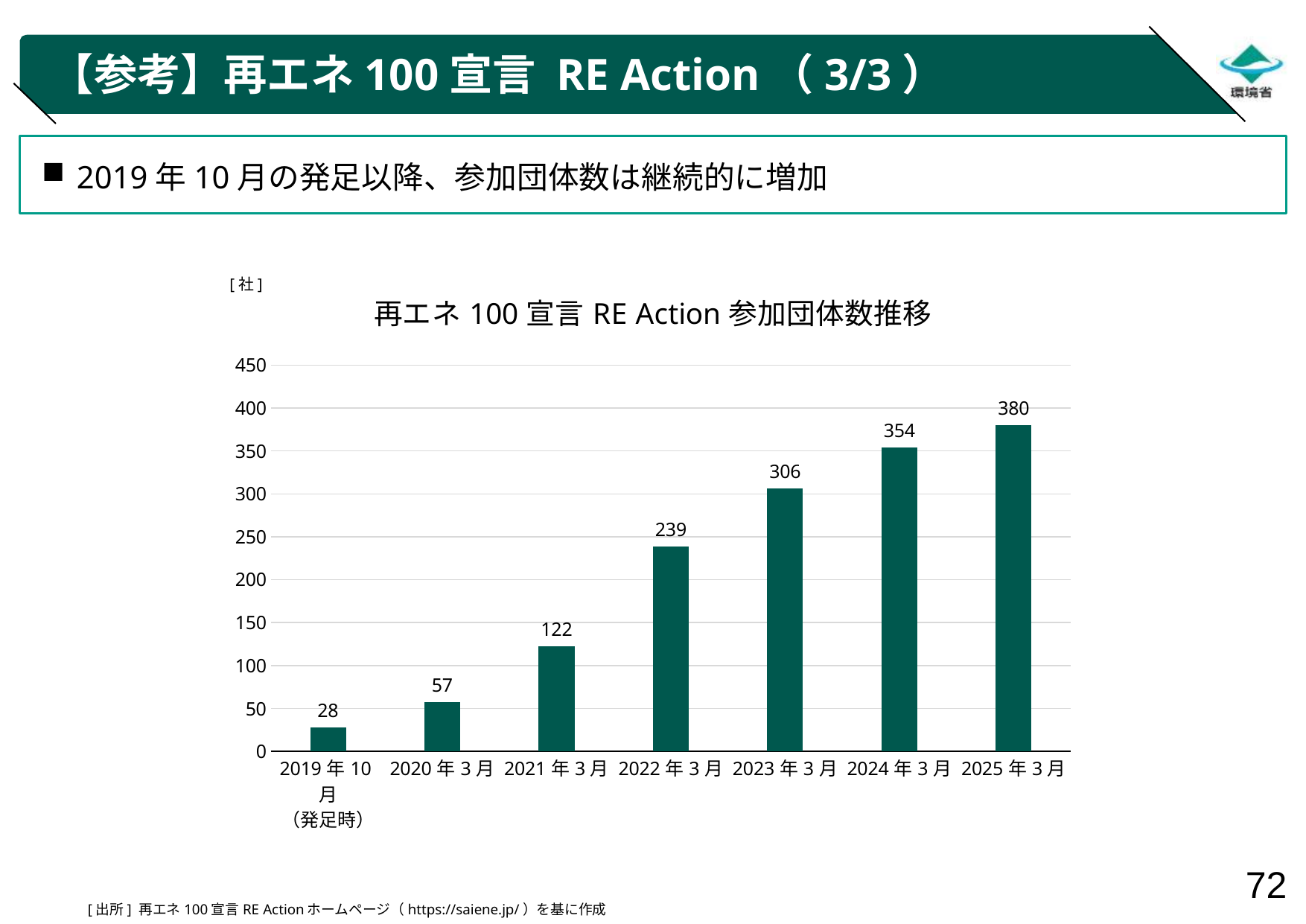
Do the values rise or fall from left to right along the x axis? rise Which category has the lowest value? 2019年10月（発足時） What kind of chart is this? bar chart What is the value for 2021年3月? 122 Which is larger, the value for 2023年3月 or the value for 2022年3月? 2023年3月 What is the difference between the values for 2022年3月 and 2020年3月? 182 What is the value for 2024年3月? 354 How many categories are shown on the x axis? 7 What is the value for 2019年10月（発足時）? 28 Which category has the highest value? 2025年3月 Is the value for 2023年3月 greater or less than 300? greater What is the difference between the values for 2025年3月 and 2024年3月? 26